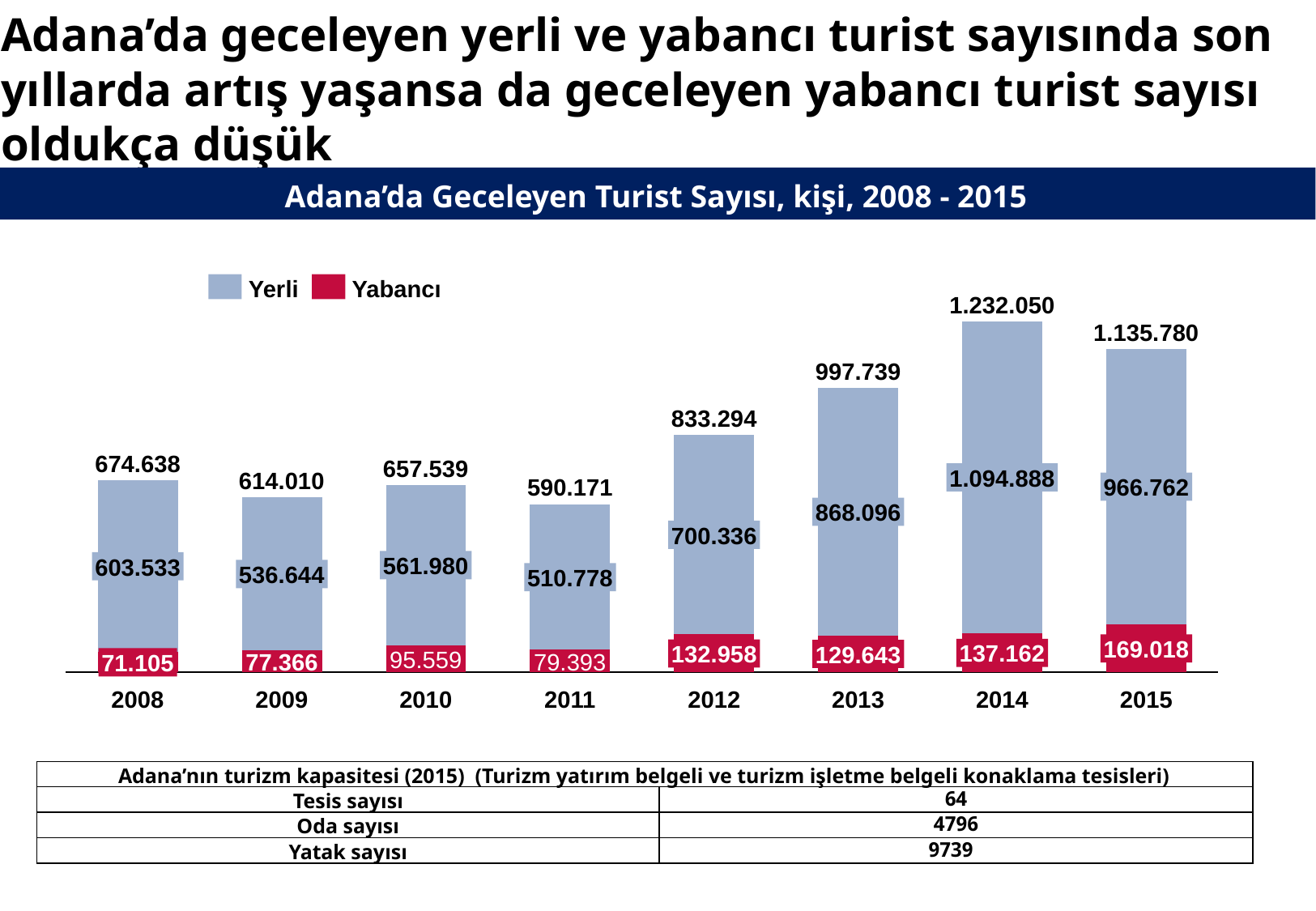
What kind of chart is shown on the slide? Stacked bar chart What is the difference between the Yerli values for 2014 and 2015? 128.126 How many years are shown on the x axis? 8 How many series does the legend list? 2 What is the Yerli value for 2012? 700.336 Which year has the lowest total number of overnight tourists? 2011 What is the total number of tourists shown for 2014? 1.232.050 Which is larger, the Yabancı value for 2012 or for 2013? 2012 What is the Yabancı value for 2015? 169.018 What is the title of the chart? Adana'da Geceleyen Turist Sayısı, kişi, 2008 - 2015 Which year has the lowest Yabancı value? 2008 Which year has the highest total number of overnight tourists? 2014